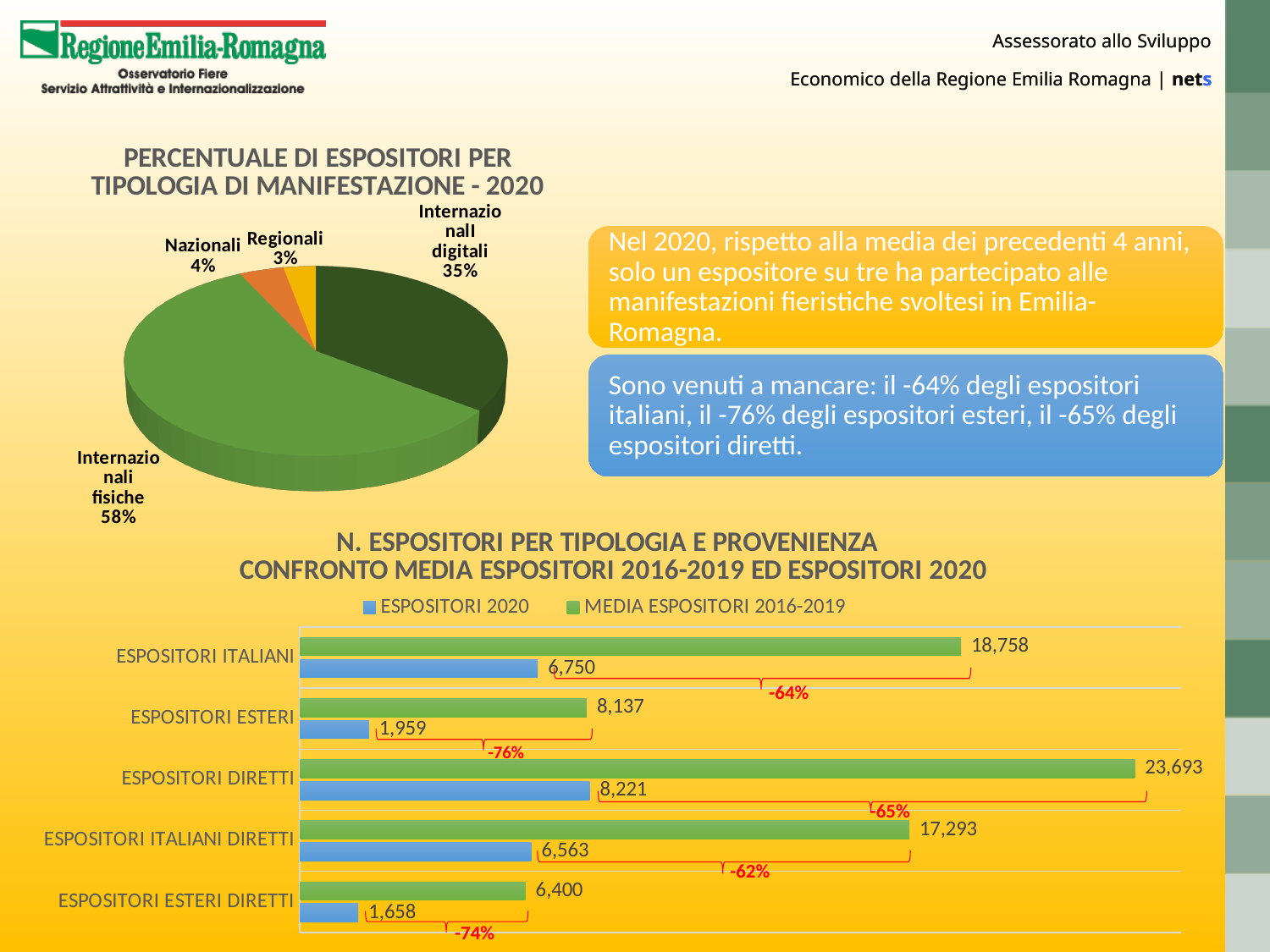
In the pie chart 'Percentuale di espositori per tipologia di manifestazione - 2020', which category has the smallest slice? Regionali What type of chart is the chart titled 'N. espositori per tipologia e provenienza'? Bar chart In the bar chart 'N. espositori per tipologia e provenienza', which category has the highest 'Media espositori 2016-2019' value? Espositori diretti How many slices does the pie chart 'Percentuale di espositori per tipologia di manifestazione - 2020' have? 4 In the bar chart 'N. espositori per tipologia e provenienza', what is the value of 'Media espositori 2016-2019' for 'Espositori diretti'? 23,693 How many series does the legend of the bar chart 'N. espositori per tipologia e provenienza' list? 2 In the bar chart 'N. espositori per tipologia e provenienza', which is larger: 'Espositori 2020' for 'Espositori italiani diretti' or 'Espositori 2020' for 'Espositori esteri diretti'? Espositori italiani diretti In the bar chart 'N. espositori per tipologia e provenienza', what is the difference between 'Media espositori 2016-2019' and 'Espositori 2020' for 'Espositori italiani'? 12,008 In the pie chart 'Percentuale di espositori per tipologia di manifestazione - 2020', what share do 'Internazionali fisiche' events have? 58% In the bar chart 'N. espositori per tipologia e provenienza', which colour represents the 'Espositori 2020' series? Blue In the pie chart 'Percentuale di espositori per tipologia di manifestazione - 2020', what is the percentage for 'Nazionali'? 4% In the bar chart 'N. espositori per tipologia e provenienza', what is the value of 'Espositori 2020' for 'Espositori esteri'? 1,959